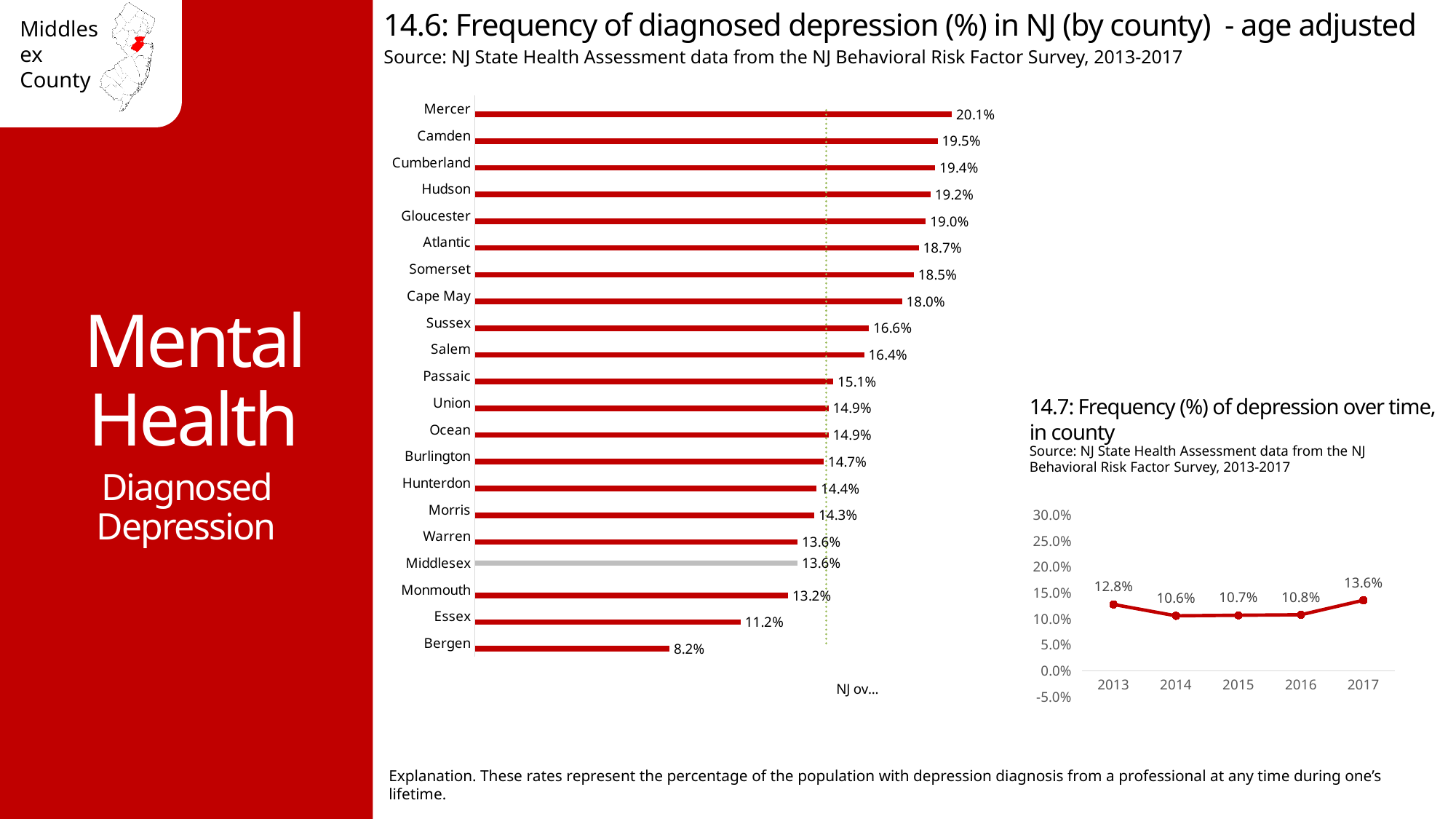
What type of chart is chart 14.6? Bar chart In chart 14.6, which county has a higher value, Hudson or Essex? Hudson In chart 14.6, which county has the lowest frequency of diagnosed depression? Bergen In chart 14.6, what is the frequency of diagnosed depression for Mercer county? 20.1% In chart 14.7, what is the difference between the 2017 and 2014 values? 3.0% In chart 14.6, what is the value shown for Middlesex county? 13.6% In chart 14.6, which county's bar is shown in grey instead of red? Middlesex In chart 14.6, which county has the highest frequency of diagnosed depression? Mercer In chart 14.7, what is the frequency of depression in 2013? 12.8% In chart 14.6, what is the difference between the values for Mercer and Bergen? 11.9% In chart 14.7, which year has the highest frequency of depression? 2017 In chart 14.6, how many counties are shown? 21